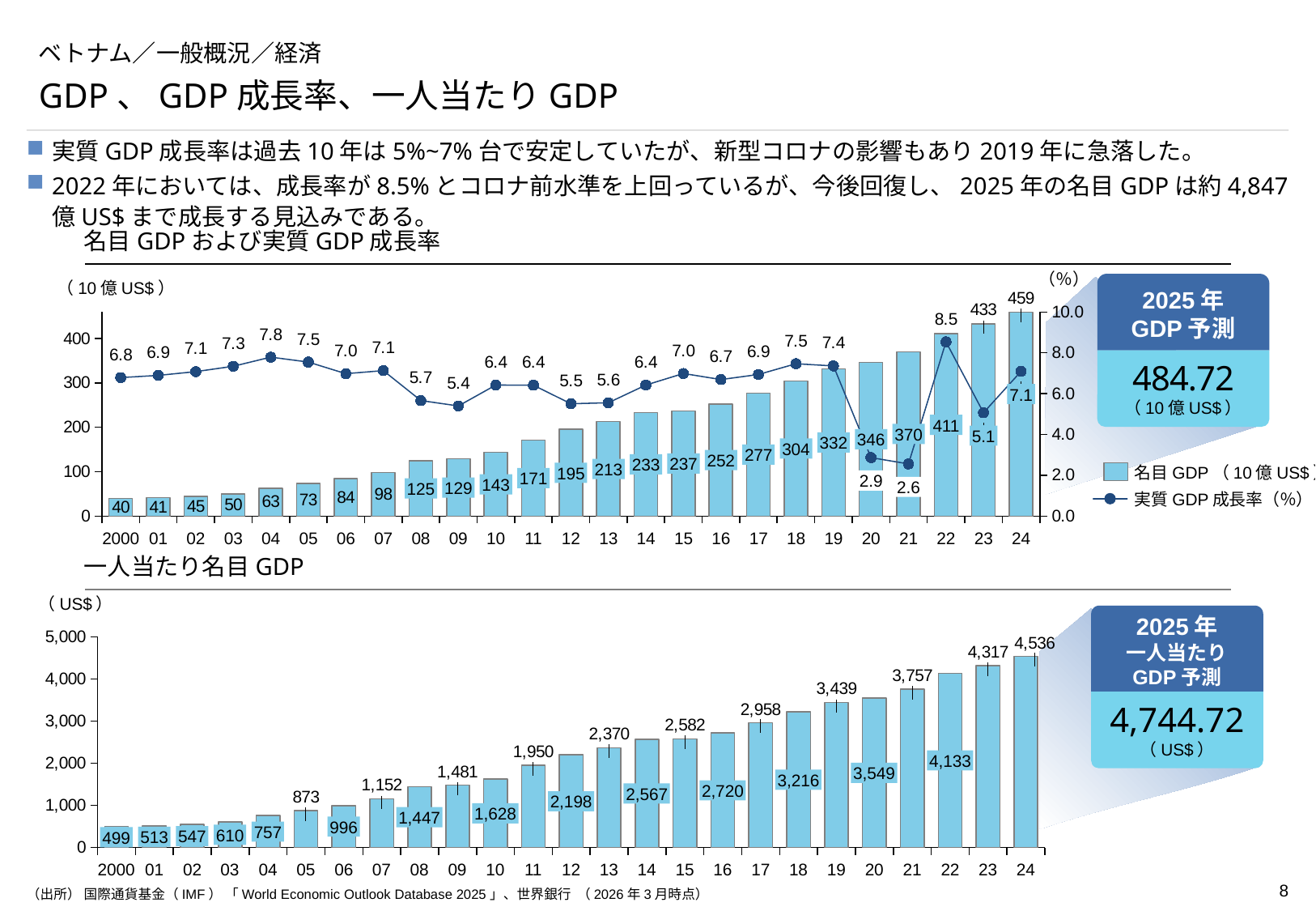
In the top chart (名目GDPおよび実質GDP成長率), how many series does the legend list? 2 In the top chart (名目GDPおよび実質GDP成長率), what is the difference in nominal GDP between 2024 and 2023? 26 In the top chart (名目GDPおよび実質GDP成長率), is the real GDP growth rate for 2020 higher or lower than for 2019? lower In the bottom chart (一人当たり名目GDP), how many years are plotted? 25 In the top chart (名目GDPおよび実質GDP成長率), what is the real GDP growth rate for 2021? 2.6 In the bottom chart (一人当たり名目GDP), what is the per capita nominal GDP for 2022? 4,133 In the top chart (名目GDPおよび実質GDP成長率), which year has the lowest nominal GDP? 2000 In the top chart (名目GDPおよび実質GDP成長率), which year has the highest real GDP growth rate? 22 In the bottom chart (一人当たり名目GDP), what is the difference in per capita GDP between 2024 and 2023? 219 In the top chart (名目GDPおよび実質GDP成長率), what is the nominal GDP value for 2024? 459 In the bottom chart (一人当たり名目GDP), do the values rise or fall from 2000 to 2024? rise What type of chart is the bottom chart (一人当たり名目GDP)? bar chart